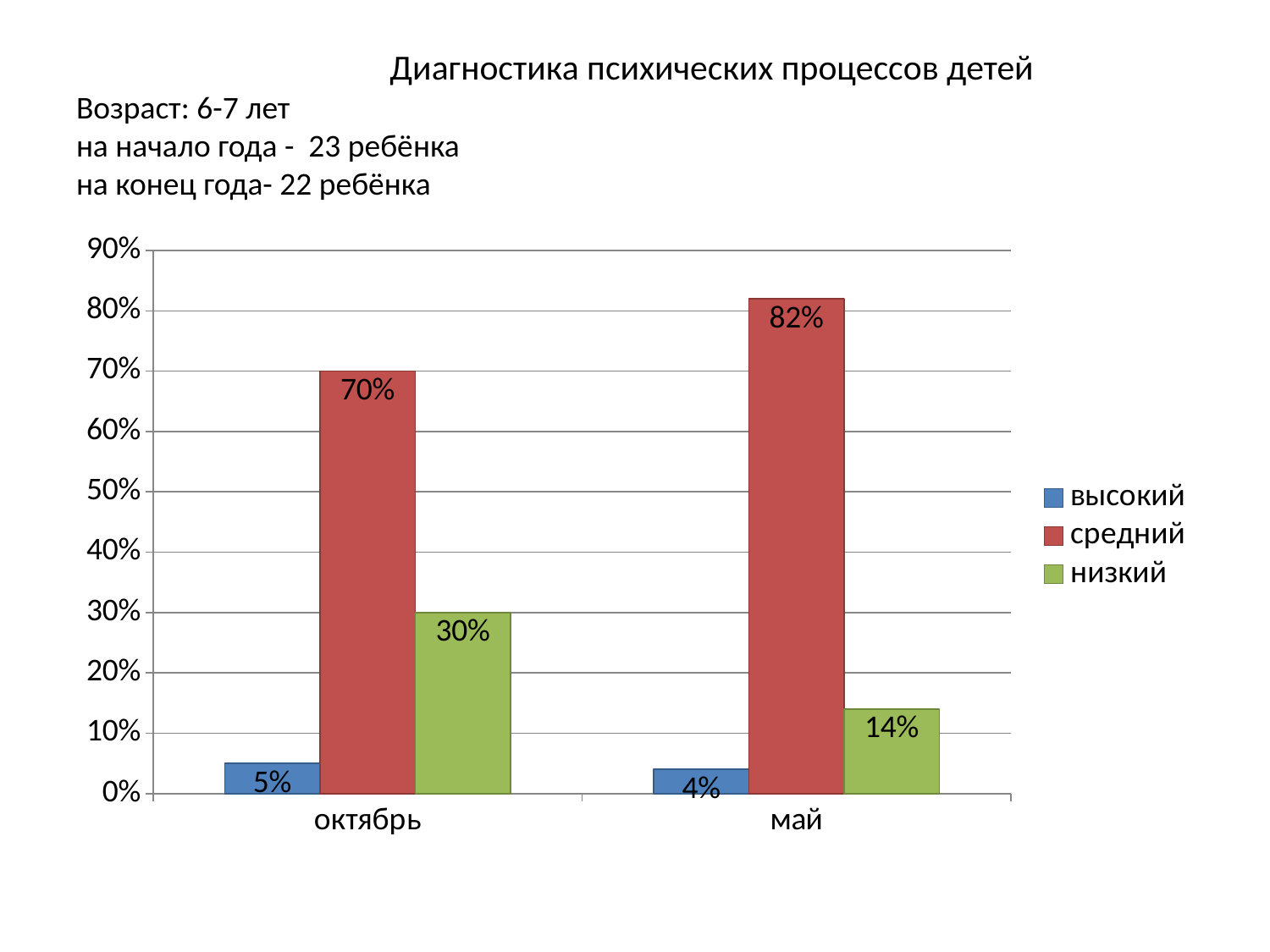
Is the value for средний in май greater or less than 80%? greater How many categories are shown on the x axis? 2 How many series does the legend list? 3 What is the value for средний in октябрь? 70% What is the title of the chart? Диагностика психических процессов детей What kind of chart is shown on the slide? bar chart What is the difference between the средний values for май and октябрь? 12% Which series has the highest value in май? средний Which is larger: низкий in октябрь or низкий in май? низкий in октябрь Which series has the lowest value in октябрь? высокий What is the value for низкий in май? 14% What is the value for высокий in октябрь? 5%